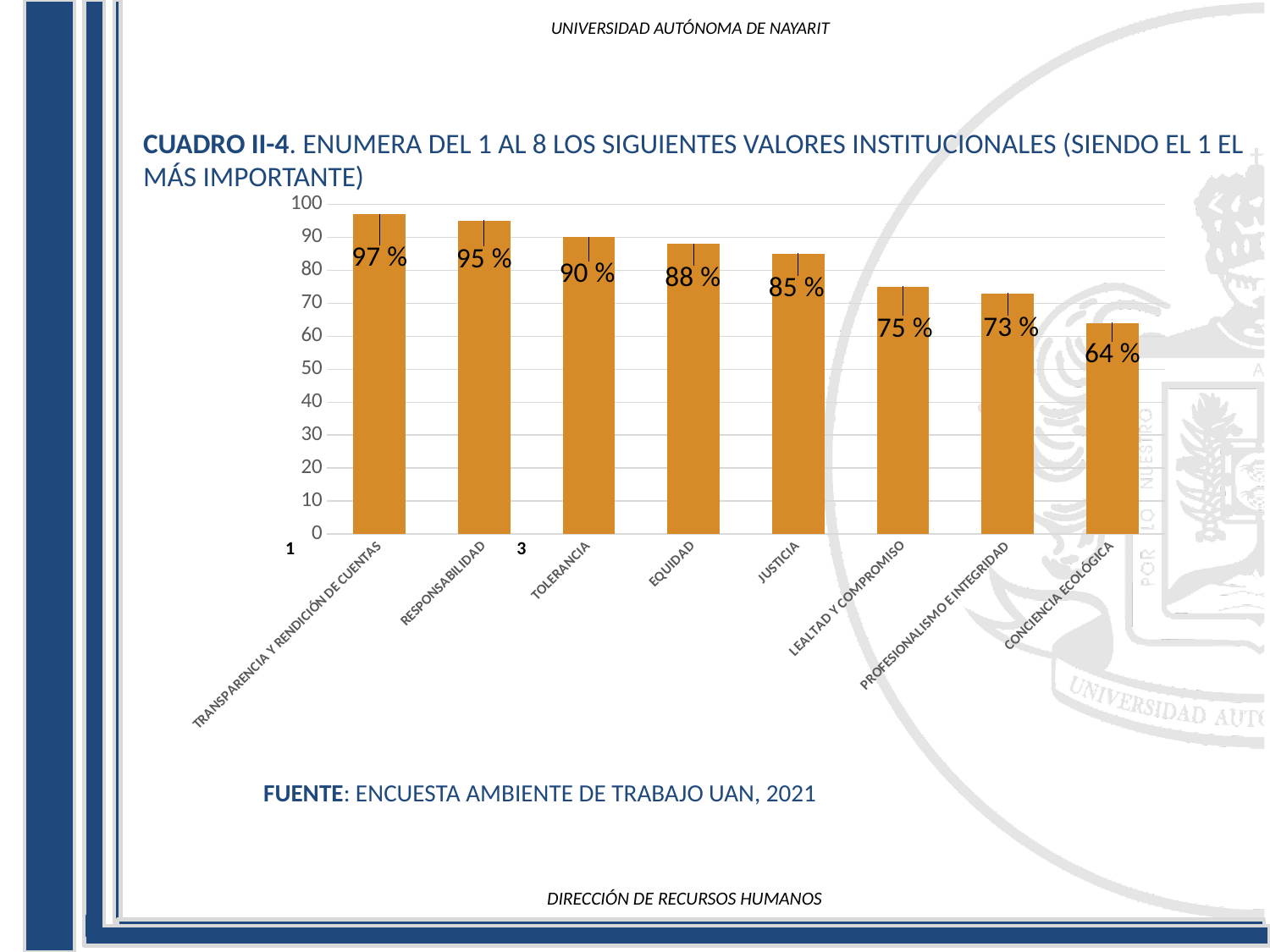
What is the value for CONCIENCIA ECOLÓGICA? 64 % What kind of chart is shown on the slide? bar chart Which category has the lowest value? CONCIENCIA ECOLÓGICA Is the value for JUSTICIA greater or less than 80? greater What is the value for LEALTAD Y COMPROMISO? 75 % Which is larger, the value for EQUIDAD or the value for PROFESIONALISMO E INTEGRIDAD? EQUIDAD Which category has the highest value? TRANSPARENCIA Y RENDICIÓN DE CUENTAS Do the values rise or fall from left to right along the x axis? fall What is the value for TRANSPARENCIA Y RENDICIÓN DE CUENTAS? 97 % What is the difference between the values for RESPONSABILIDAD and JUSTICIA? 10 % How many categories are shown in the chart? 8 What is the value for TOLERANCIA? 90 %